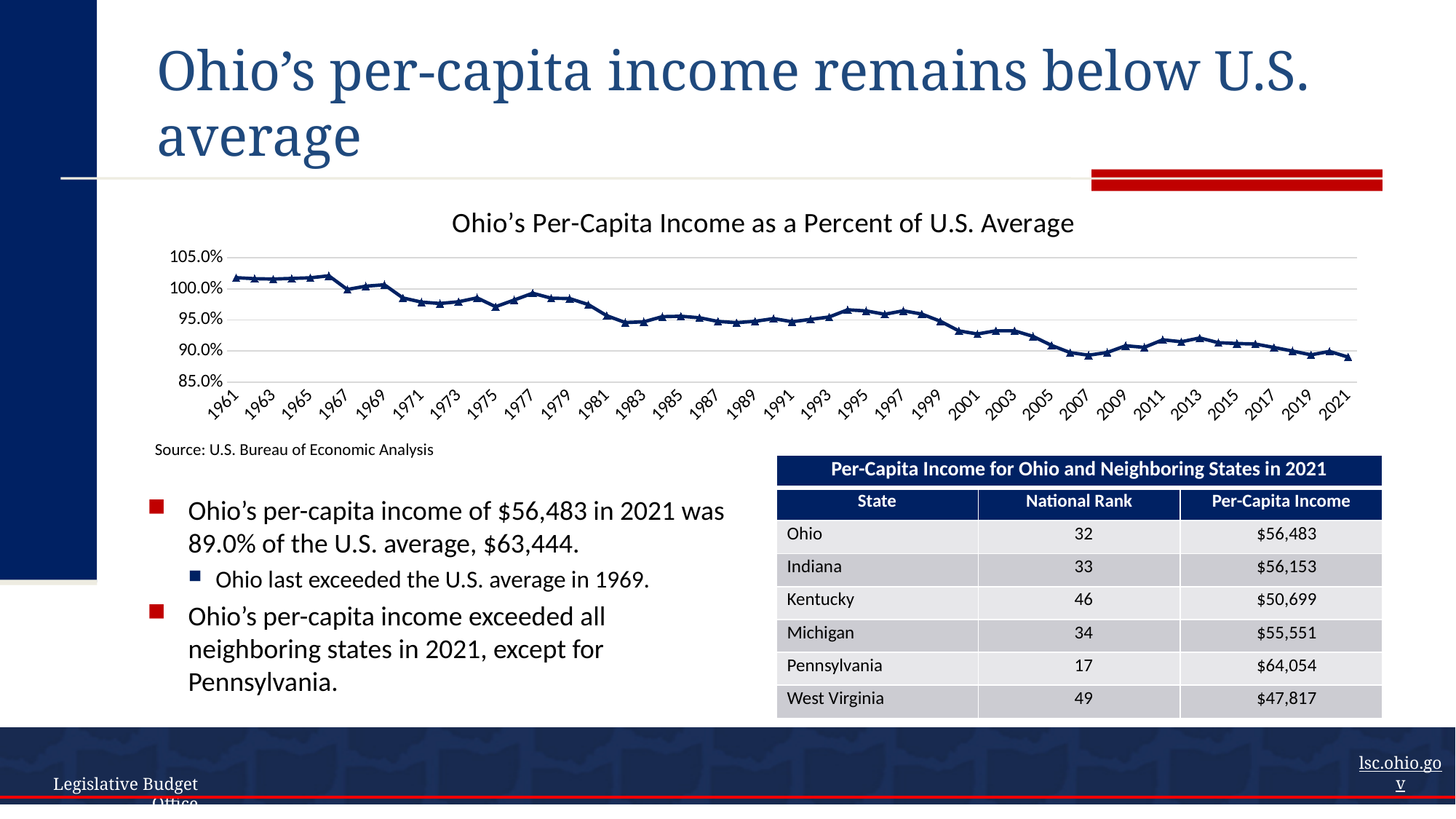
Is the value for 2013 greater or less than 90.0%? greater Is the value for 1975 greater or less than 100.0%? less Is the value for 2001 greater or less than 95.0%? less Which year has the larger value, 1995 or 2005? 1995 What kind of chart is shown on the slide? line chart Which year has the larger value, 1961 or 2021? 1961 Overall, do the values in the chart rise or fall from 1961 to 2021? fall What are the first and last years labeled on the x axis of the chart? 1961 and 2021 What is the title of the chart? Ohio's Per-Capita Income as a Percent of U.S. Average